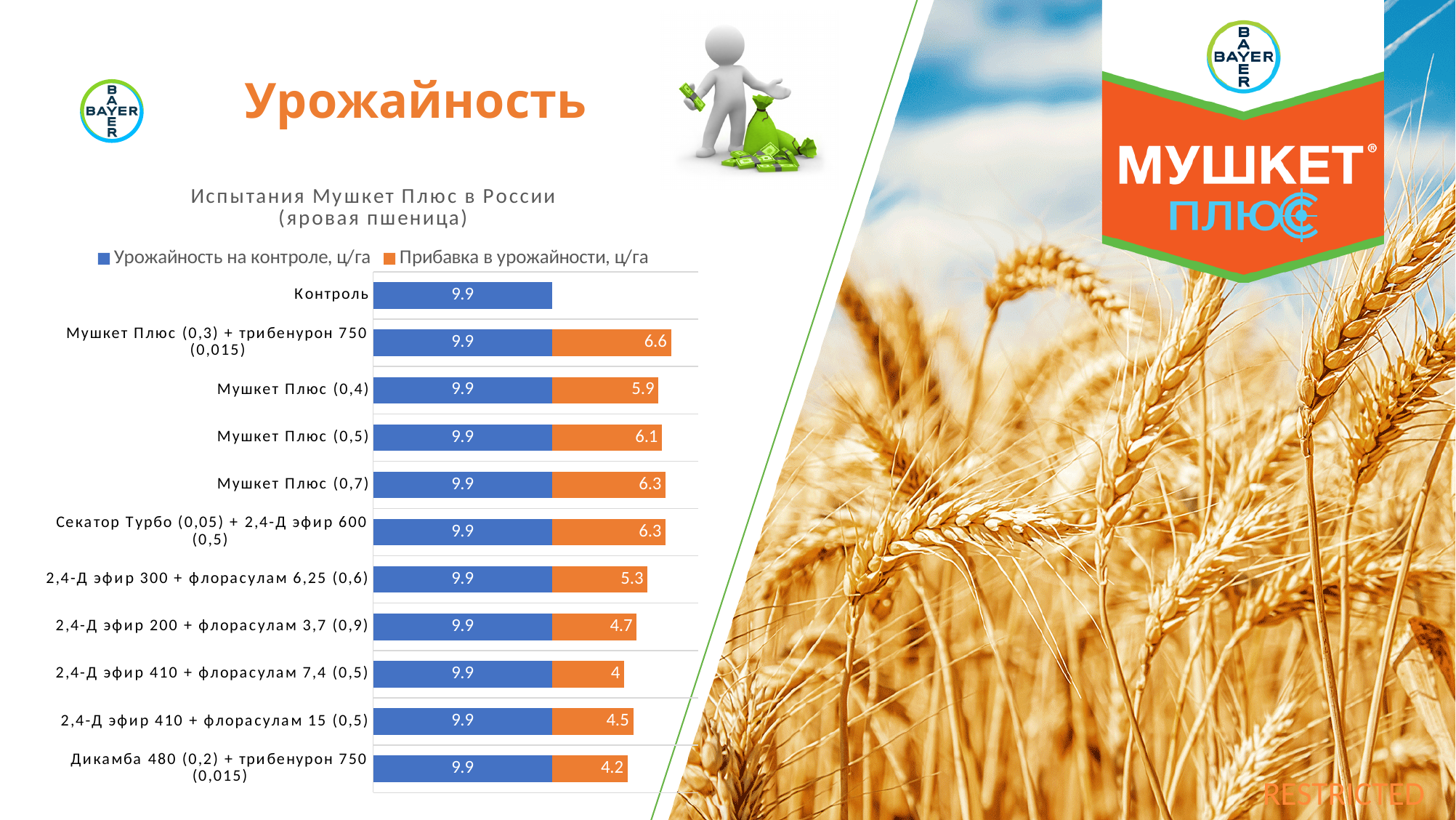
How many series does the chart legend list? 2 Which treatment has the highest 'Прибавка в урожайности, ц/га'? Мушкет Плюс (0,3) + трибенурон 750 (0,015) Among treatments with a 'Прибавка в урожайности' value, which has the lowest? 2,4-Д эфир 410 + флорасулам 7,4 (0,5) What is the value of 'Урожайность на контроле, ц/га' for 'Контроль'? 9.9 What is the title of the chart? Испытания Мушкет Плюс в России (яровая пшеница) What is the value of 'Прибавка в урожайности, ц/га' for 'Мушкет Плюс (0,3) + трибенурон 750 (0,015)'? 6.6 Which has a larger 'Прибавка в урожайности, ц/га': 'Мушкет Плюс (0,5)' or 'Дикамба 480 (0,2) + трибенурон 750 (0,015)'? Мушкет Плюс (0,5) How many categories (treatments) are shown in the chart? 11 What is the value of 'Прибавка в урожайности, ц/га' for '2,4-Д эфир 410 + флорасулам 7,4 (0,5)'? 4 What is the difference in 'Прибавка в урожайности, ц/га' between 'Мушкет Плюс (0,7)' and 'Мушкет Плюс (0,4)'? 0.4 What is the total of the stacked bar for 'Мушкет Плюс (0,3) + трибенурон 750 (0,015)'? 16.5 What type of chart is shown on the slide? Stacked bar chart